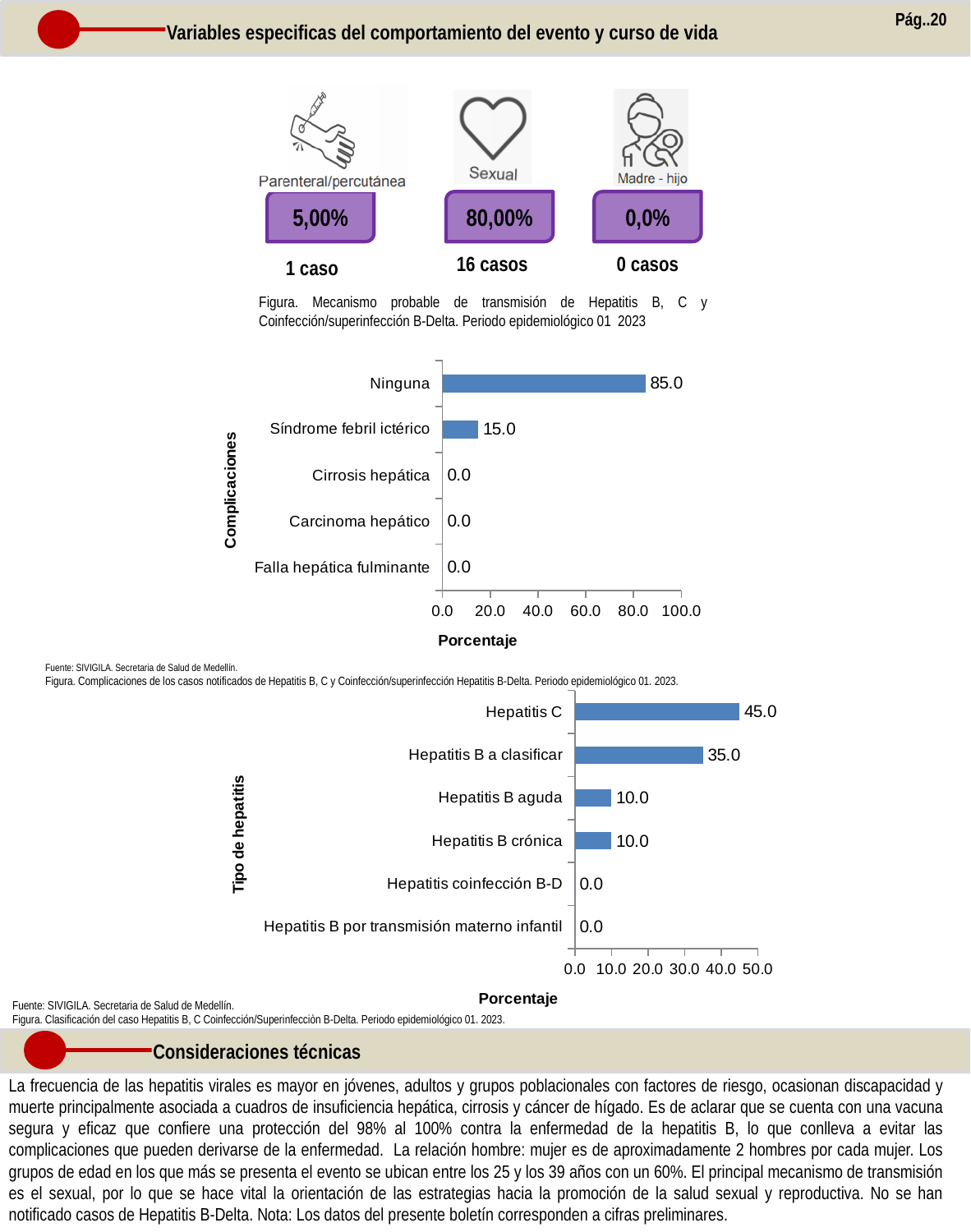
What type of chart is the lower chart (Tipo de hepatitis)? Bar chart In the upper bar chart (Complicaciones), how many categories are shown? 5 In the lower bar chart (Tipo de hepatitis), what is the difference between the values for Hepatitis C and Hepatitis B a clasificar? 10.0 In the lower bar chart (Tipo de hepatitis), how many categories are shown? 6 In the lower bar chart (Tipo de hepatitis), which category has the highest value? Hepatitis C In the upper bar chart (Complicaciones), what is the value for Síndrome febril ictérico? 15.0 In the upper bar chart (Complicaciones), what is the label of the x axis? Porcentaje In the lower bar chart (Tipo de hepatitis), what is the value for Hepatitis C? 45.0 In the upper bar chart (Complicaciones), which category has the highest value? Ninguna In the upper bar chart (Complicaciones), what is the value for Ninguna? 85.0 In the lower bar chart (Tipo de hepatitis), what is the value for Hepatitis B a clasificar? 35.0 In the upper bar chart (Complicaciones), what is the difference between the values for Ninguna and Síndrome febril ictérico? 70.0